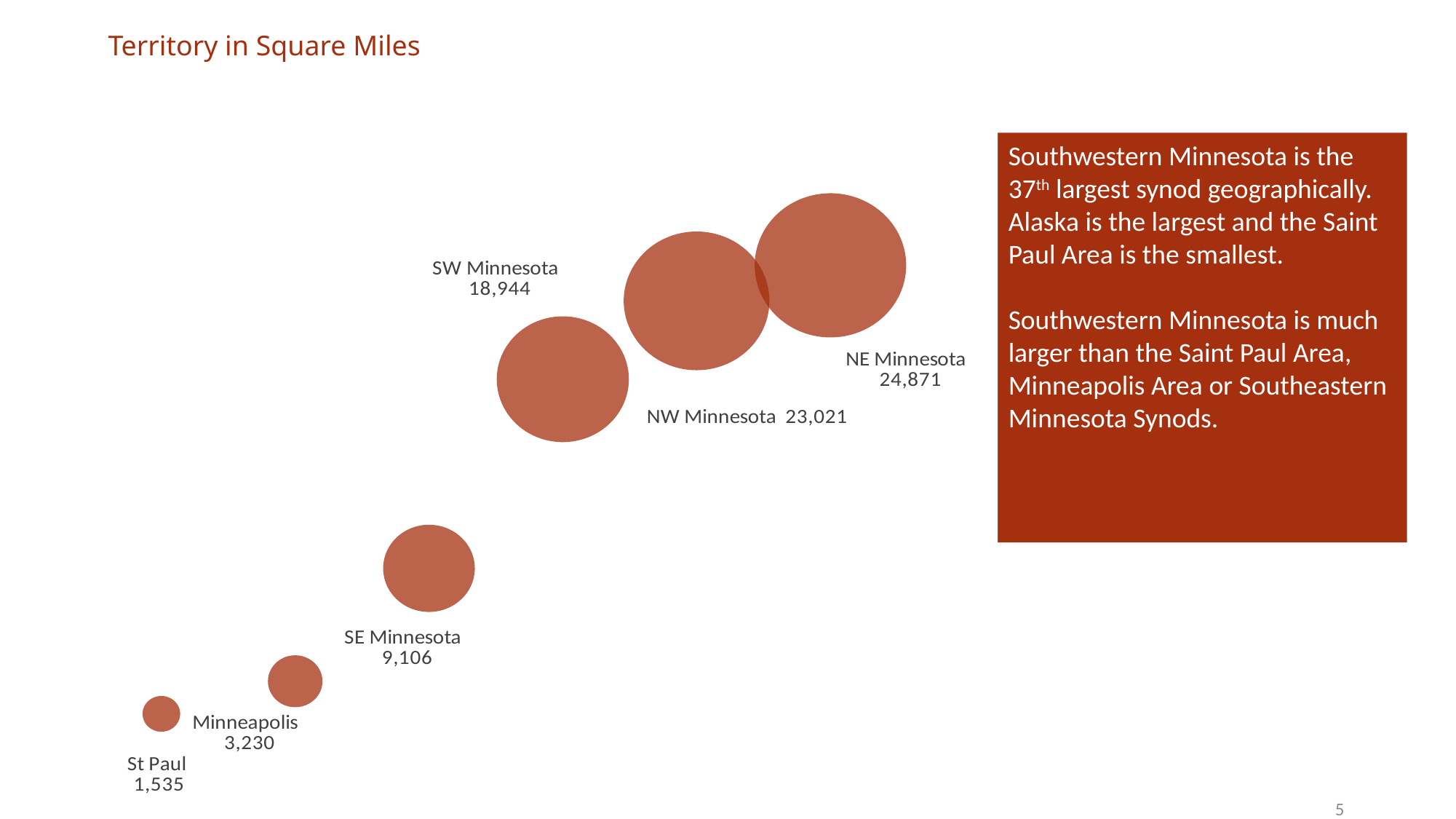
What is the title of the chart? Territory in Square Miles Which synod has the largest territory in square miles? NE Minnesota Which synod has the smallest territory in square miles? St Paul What is the territory in square miles for NW Minnesota? 23,021 What is the difference in square miles between NE Minnesota and NW Minnesota? 1,850 What is the territory in square miles for St Paul? 1,535 What kind of chart is shown on the slide? Bubble chart What is the difference in square miles between Minneapolis and St Paul? 1,695 What is the territory in square miles for SE Minnesota? 9,106 Which has a larger territory, SE Minnesota or Minneapolis? SE Minnesota What is the territory in square miles for SW Minnesota? 18,944 How many synods are plotted on the chart? 6